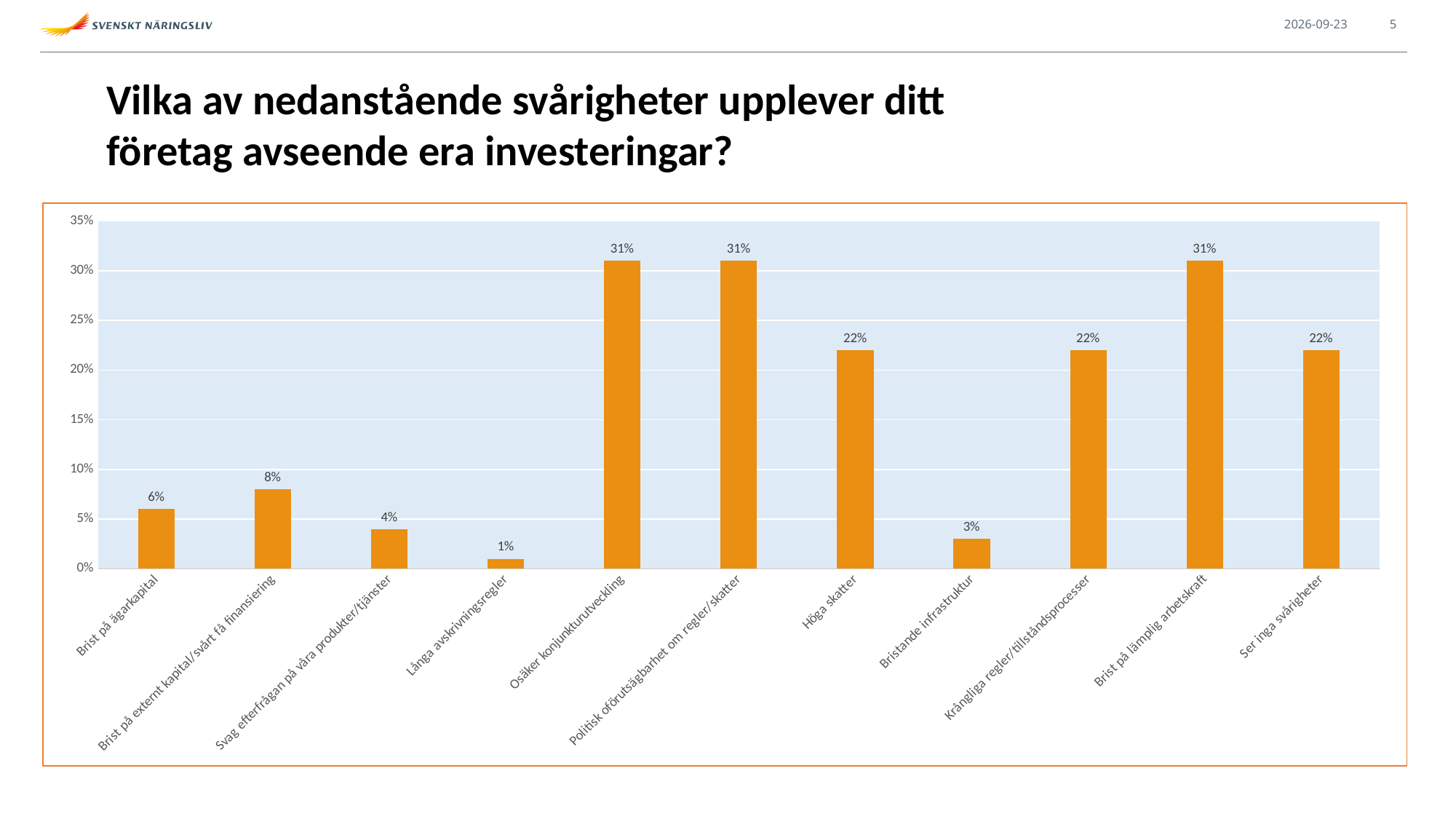
What kind of chart is shown on the slide? bar chart What is the value for "Osäker konjunkturutveckling"? 31% What is the difference between the values for "Brist på ägarkapital" and "Svag efterfrågan på våra produkter/tjänster"? 2% Which is larger, the value for "Krångliga regler/tillståndsprocesser" or the value for "Bristande infrastruktur"? Krångliga regler/tillståndsprocesser Is the value for "Politisk oförutsägbarhet om regler/skatter" greater or less than 25%? greater What is the value for "Bristande infrastruktur"? 3% How many categories are shown on the x axis? 11 Which category has the lowest value? Långa avskrivningsregler What is the value for "Höga skatter"? 22% What is the difference between the values for "Brist på lämplig arbetskraft" and "Ser inga svårigheter"? 9% What is the value for "Brist på externt kapital/svårt få finansiering"? 8% What colour are the bars in the chart? orange